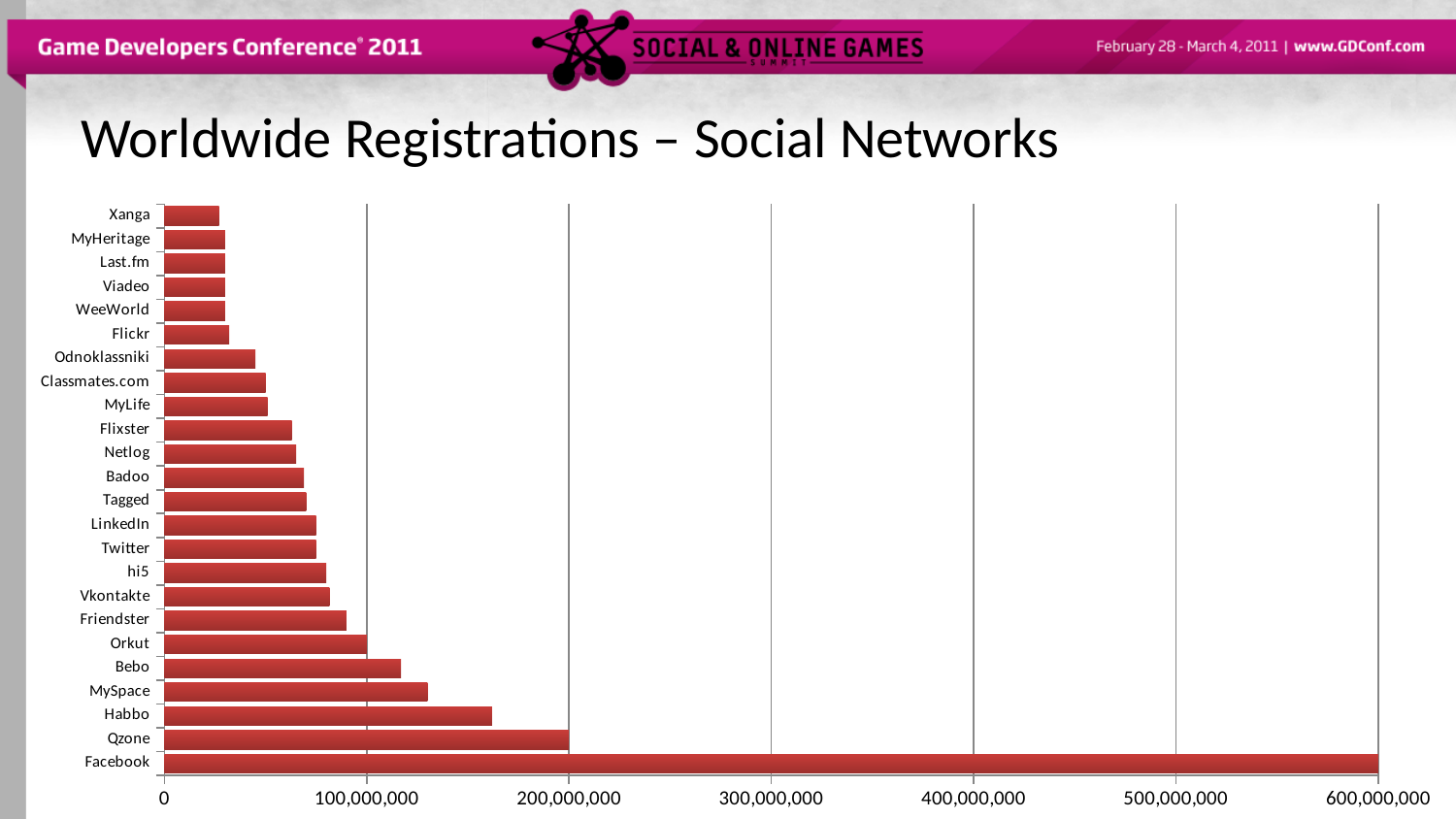
Do the bars get longer or shorter going from the top of the chart (Xanga) to the bottom (Facebook)? longer What is the title of the chart? Worldwide Registrations – Social Networks What is the value for Facebook? 600,000,000 Is the value for MySpace greater or less than 200,000,000? less Which has more registrations, Habbo or MySpace? Habbo Which has more registrations, Bebo or Orkut? Bebo Is the value for Twitter greater or less than 100,000,000? less Is the value for Habbo greater or less than 100,000,000? greater Which social network has the highest number of worldwide registrations? Facebook What kind of chart is shown on the slide? bar chart How many social networks are plotted in the chart? 24 What is the value for Qzone? 200,000,000